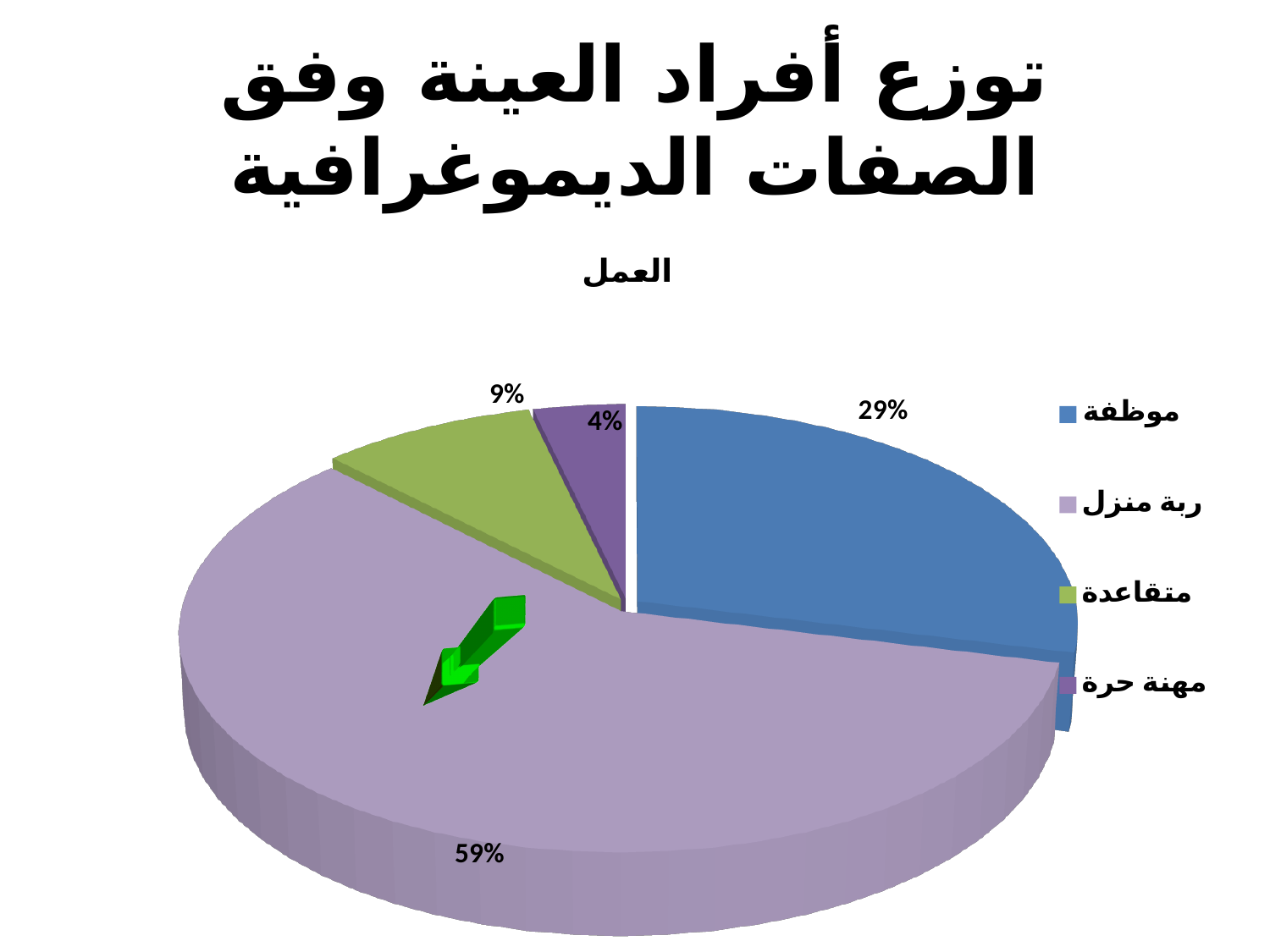
What percentage of the sample is labelled موظفة in the pie chart? 29% What is the title of the chart? العمل How many categories are shown in the pie chart? 4 Which category has the largest slice of the pie chart? ربة منزل Which is larger, the slice for موظفة or the slice for متقاعدة? موظفة What percentage of the sample is labelled مهنة حرة in the pie chart? 4% What percentage of the sample is labelled ربة منزل in the pie chart? 59% What is the difference in percentage points between متقاعدة and مهنة حرة? 5 What type of chart is shown on the slide? pie chart What is the difference in percentage points between ربة منزل and موظفة? 30 What percentage of the sample is labelled متقاعدة in the pie chart? 9% Which category has the smallest slice of the pie chart? مهنة حرة